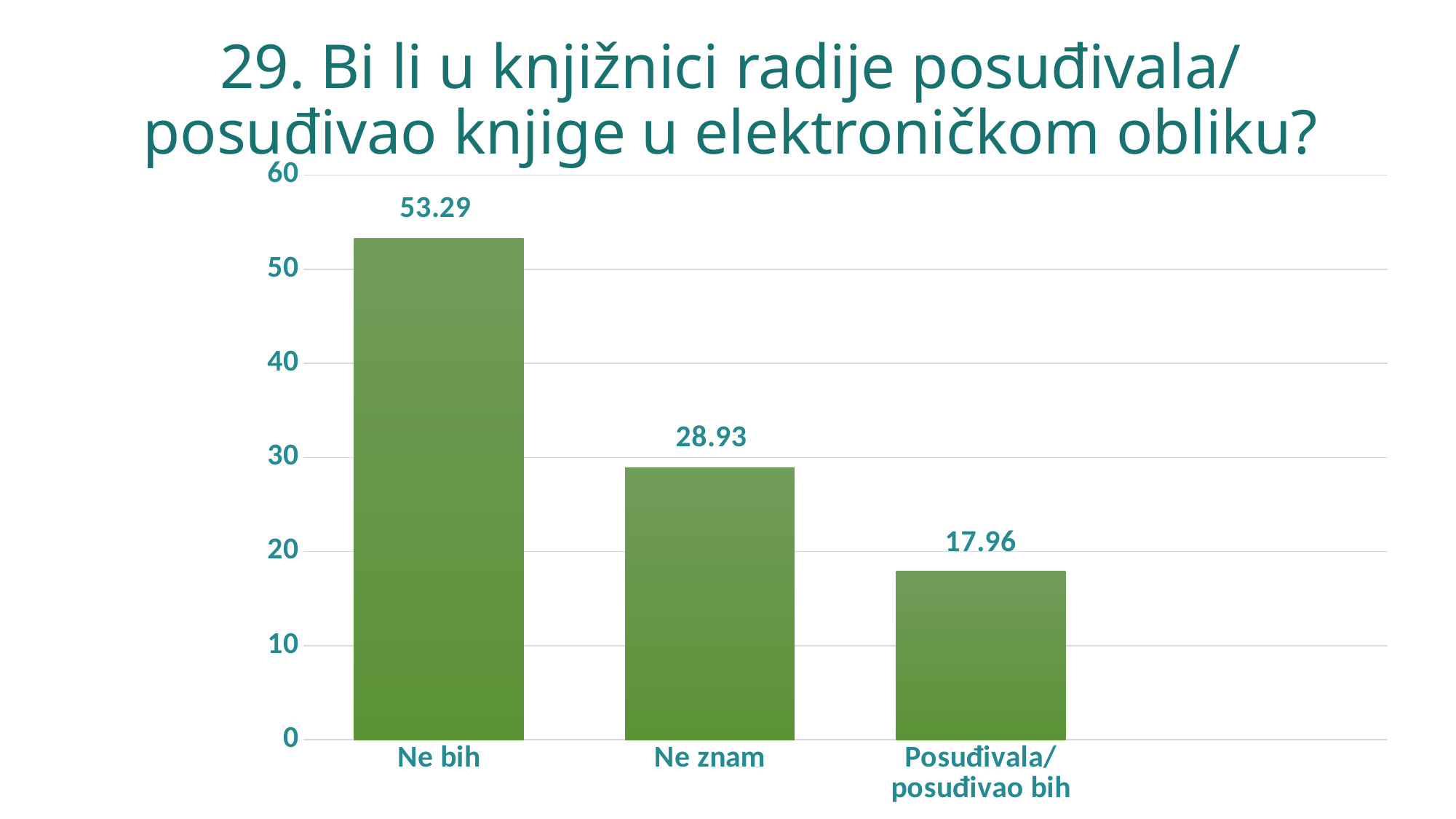
Which category has the highest value? Ne bih How many categories are shown in the chart? 3 What is the difference between the values for "Ne bih" and "Ne znam"? 24.36 Do the values rise or fall from left to right across the categories? fall What is the difference between the values for "Ne znam" and "Posuđivala/ posuđivao bih"? 10.97 What is the value for "Ne znam"? 28.93 What is the value for "Ne bih"? 53.29 Which is larger, the value for "Ne znam" or the value for "Posuđivala/ posuđivao bih"? Ne znam Is the value for "Ne bih" greater or less than 50? greater What is the value for "Posuđivala/ posuđivao bih"? 17.96 What kind of chart is shown on the slide? bar chart Which category has the lowest value? Posuđivala/ posuđivao bih